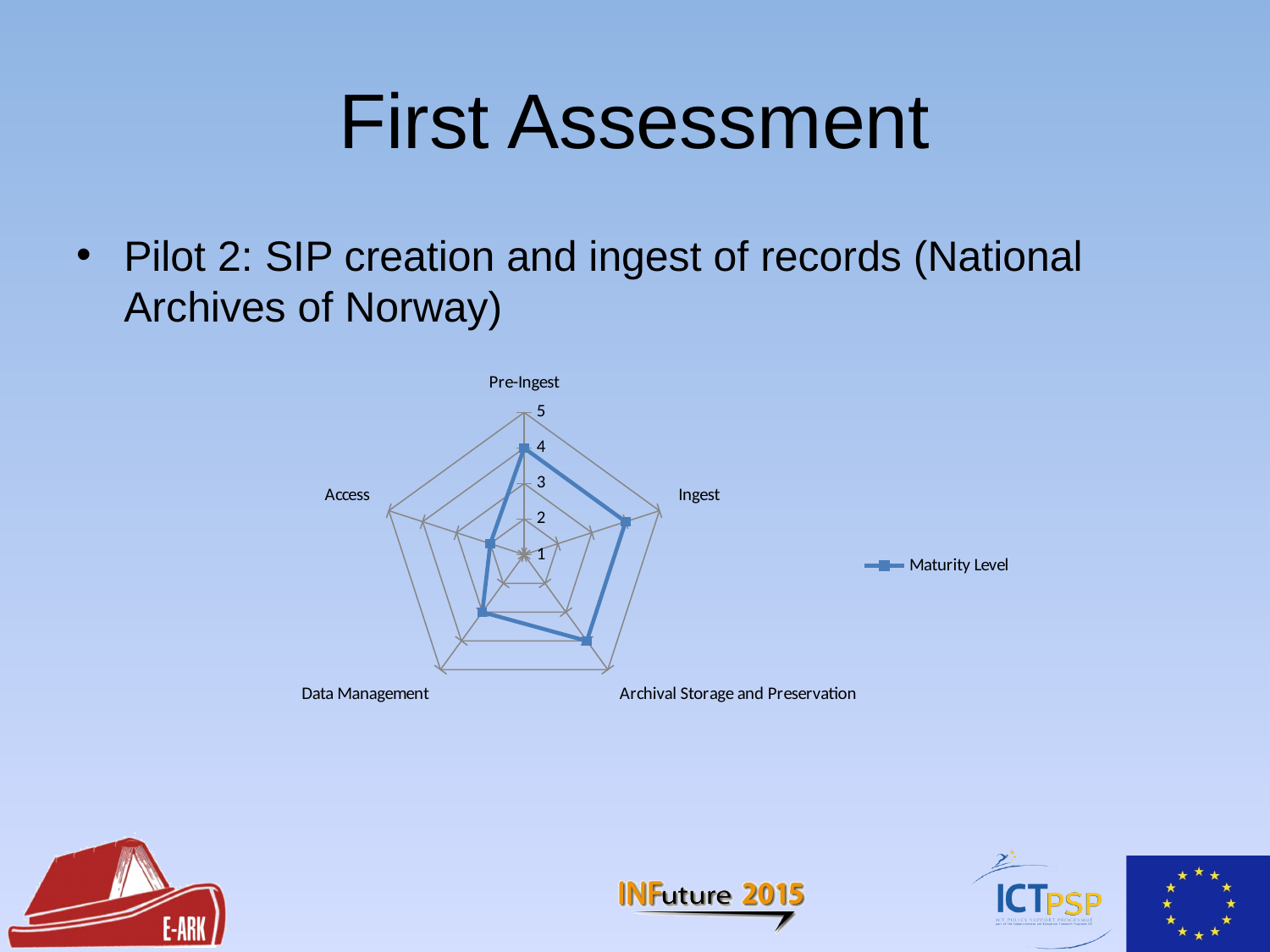
What is the Maturity Level value for Pre-Ingest? 4 How many categories (axes) does the radar chart have? 5 Is the Maturity Level for Archival Storage and Preservation greater or less than 3? greater Which has a higher Maturity Level, Ingest or Access? Ingest Is the Maturity Level for Access greater or less than 3? less What is the highest value shown on the chart's scale? 5 What is the name of the series shown in the chart legend? Maturity Level How many series does the legend of the chart list? 1 Which category has the lowest Maturity Level? Access What kind of chart is shown on the slide? radar chart Is the Maturity Level for Ingest greater or less than 3? greater